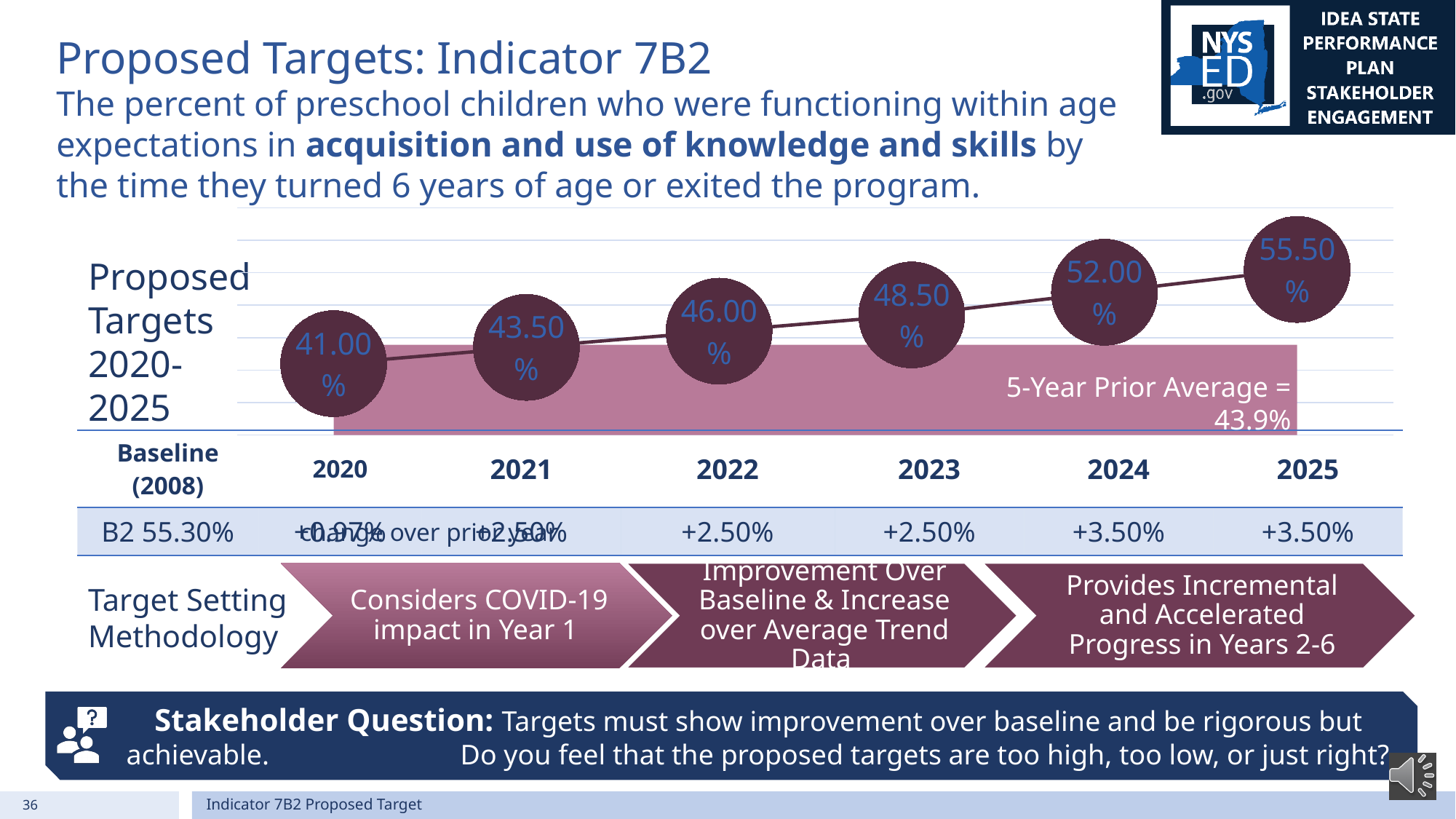
What is the proposed target for 2020? 41.00% What is the difference between the proposed targets for 2025 and 2020? 14.50% Do the proposed targets rise or fall from 2020 to 2025? rise Which year has the lowest proposed target? 2020 How many years are plotted on the chart? 6 What is the proposed target for 2023? 48.50% What is the difference between the proposed targets for 2024 and 2023? 3.50% What is the proposed target for 2025? 55.50% Which is larger, the proposed target for 2022 or for 2021? 2022 Which year has the highest proposed target? 2025 What is the 5-Year Prior Average shown on the chart? 43.9% What kind of chart is used to show the proposed targets? line chart